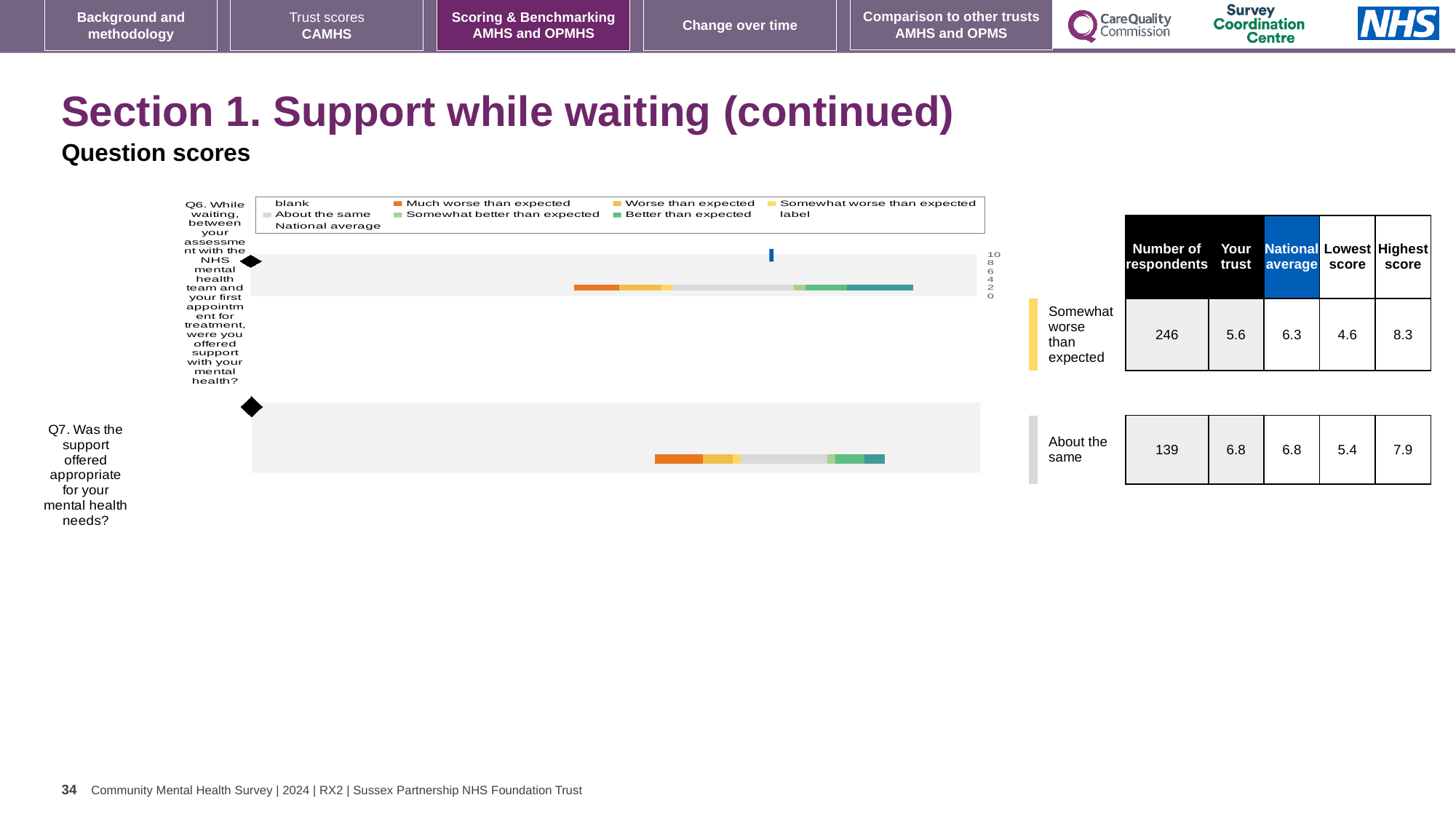
What is the highest score for Q7? 7.9 What benchmark category label is shown next to the Q6 bar? Somewhat worse than expected What is the national average score for Q6? 6.3 What is the number of respondents for Q6 (support while waiting)? 246 What kind of chart is used to show the question scores on this slide? Bar chart What is the 'Your trust' score for Q7 (was the support offered appropriate)? 6.8 How many questions are plotted in the chart on this slide? 2 What is the lowest score for Q6? 4.6 Which question has more respondents, Q6 or Q7? Q6 For Q6, which is larger: the trust's score or the national average? National average What is the 'Your trust' score for Q6? 5.6 What is the difference between the highest score and the lowest score for Q6? 3.7